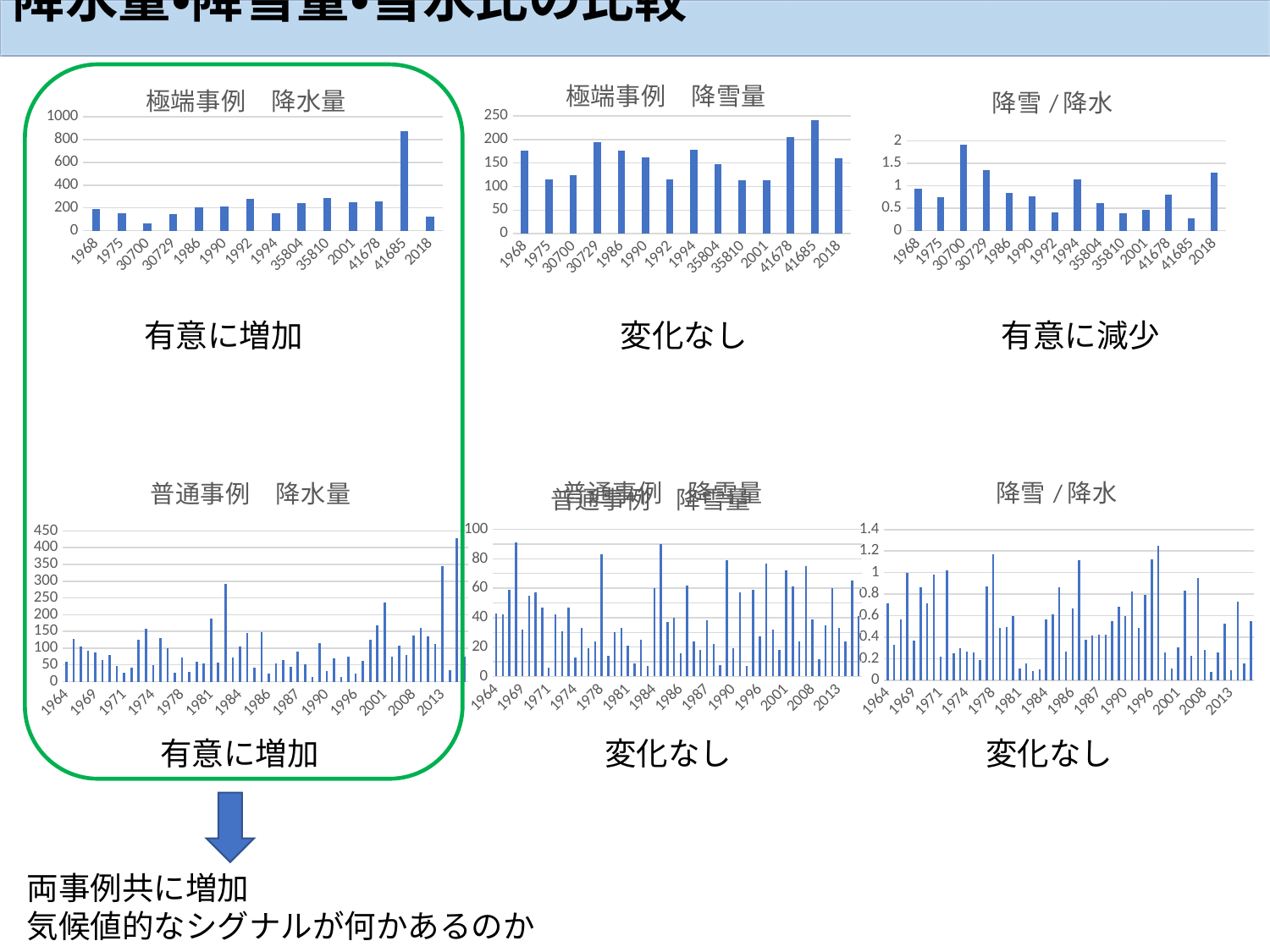
What type of chart is the top-left chart titled 極端事例 降水量? bar chart How many charts are shown on the slide? 6 What text is written directly below the top-left chart titled 極端事例 降水量? 有意に増加 In the top-right chart titled 降雪/降水, which category has the highest value? 30700 In the top-left chart titled 極端事例 降水量, how many categories are shown on the x axis? 14 In the top-right chart titled 降雪/降水, is the value for 2018 greater or less than 1? greater In the top-middle chart titled 極端事例 降雪量, is the value for 41685 greater or less than 200? greater In the top-left chart titled 極端事例 降水量, is the value for 30700 greater or less than 100? less In the top-left chart titled 極端事例 降水量, which category has the lowest value? 30700 In the top-left chart titled 極端事例 降水量, which category has the highest value? 41685 In the top-middle chart titled 極端事例 降雪量, which category has the highest value? 41685